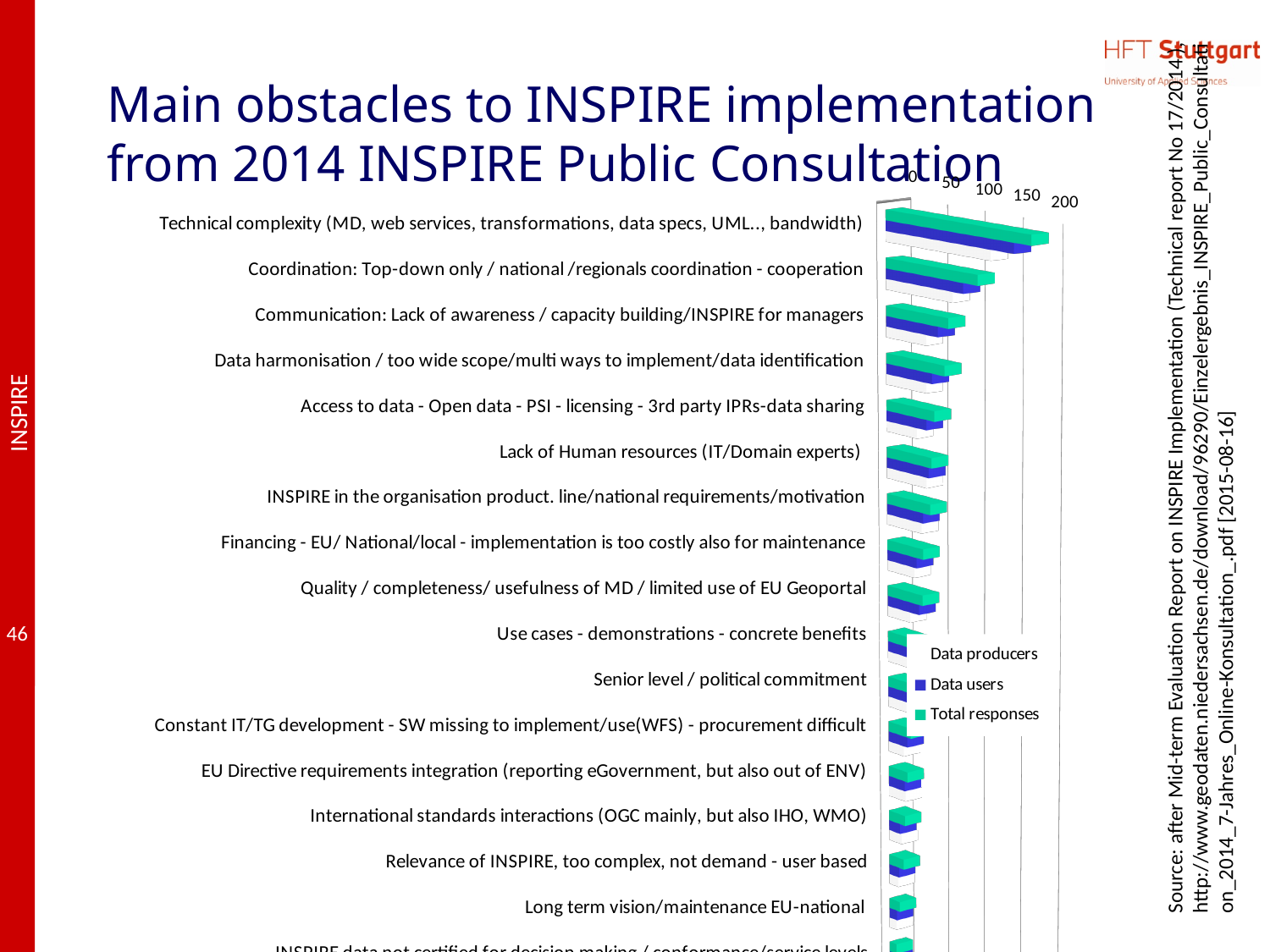
What kind of chart is shown on the slide? bar chart How many series does the chart legend list? 3 Is the Total responses value for Coordination: Top-down only / national /regionals coordination - cooperation greater or less than 50? greater What is the highest tick value shown on the chart's value axis? 200 Is the Total responses value for Technical complexity greater or less than 150? greater Which obstacle category has the highest number of responses? Technical complexity (MD, web services, transformations, data specs, UML.., bandwidth) Do the bar lengths generally increase or decrease going down the list of categories from top to bottom? decrease Which has more total responses: Technical complexity or Coordination: Top-down only / national /regionals coordination - cooperation? Technical complexity Is the Total responses value for Communication: Lack of awareness / capacity building/INSPIRE for managers greater or less than 100? less Which series are listed in the chart legend? Data producers, Data users, Total responses